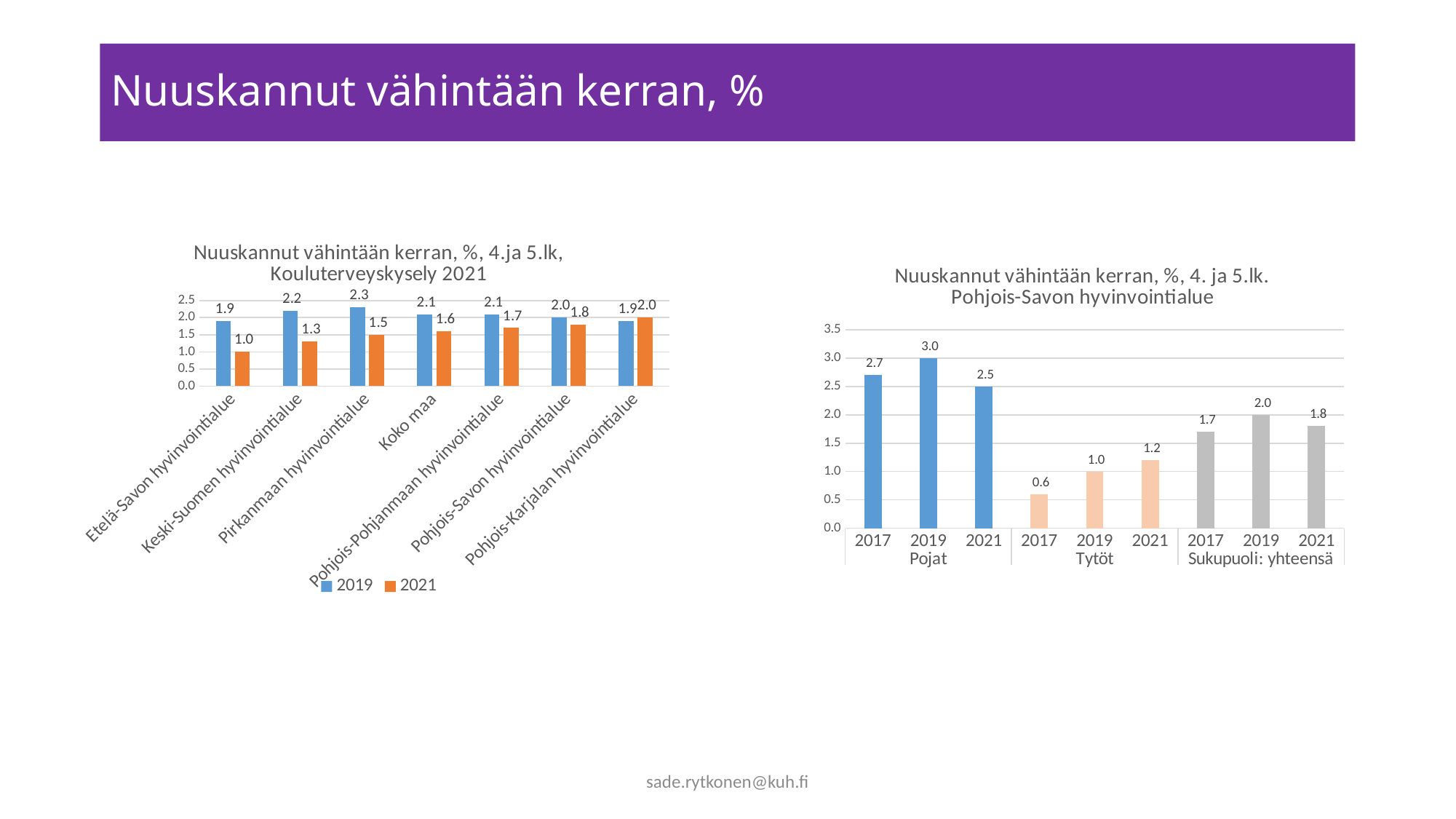
In the left chart (Koulutervyskysely 2021), what is the 2021 value for Etelä-Savon hyvinvointialue? 1.0 In the right chart (Pohjois-Savon hyvinvointialue), what is the value for Pojat in 2019? 3.0 In the left chart, how many categories are shown on the x axis? 7 In the left chart, what is the 2019 value for Pirkanmaan hyvinvointialue? 2.3 In the right chart, do the values for Tytöt rise or fall from 2017 to 2021? rise In the left chart, which category has the lowest 2021 value? Etelä-Savon hyvinvointialue In the right chart, is the value for Pojat in 2021 larger or smaller than the value for Sukupuoli: yhteensä in 2021? larger In the right chart, what is the value for Tytöt in 2017? 0.6 In the left chart, which category has the highest 2019 value? Pirkanmaan hyvinvointialue What kind of chart is the right chart? bar chart In the left chart, what is the difference between the 2019 and 2021 values for Keski-Suomen hyvinvointialue? 0.9 In the left chart, how many series does the legend list? 2